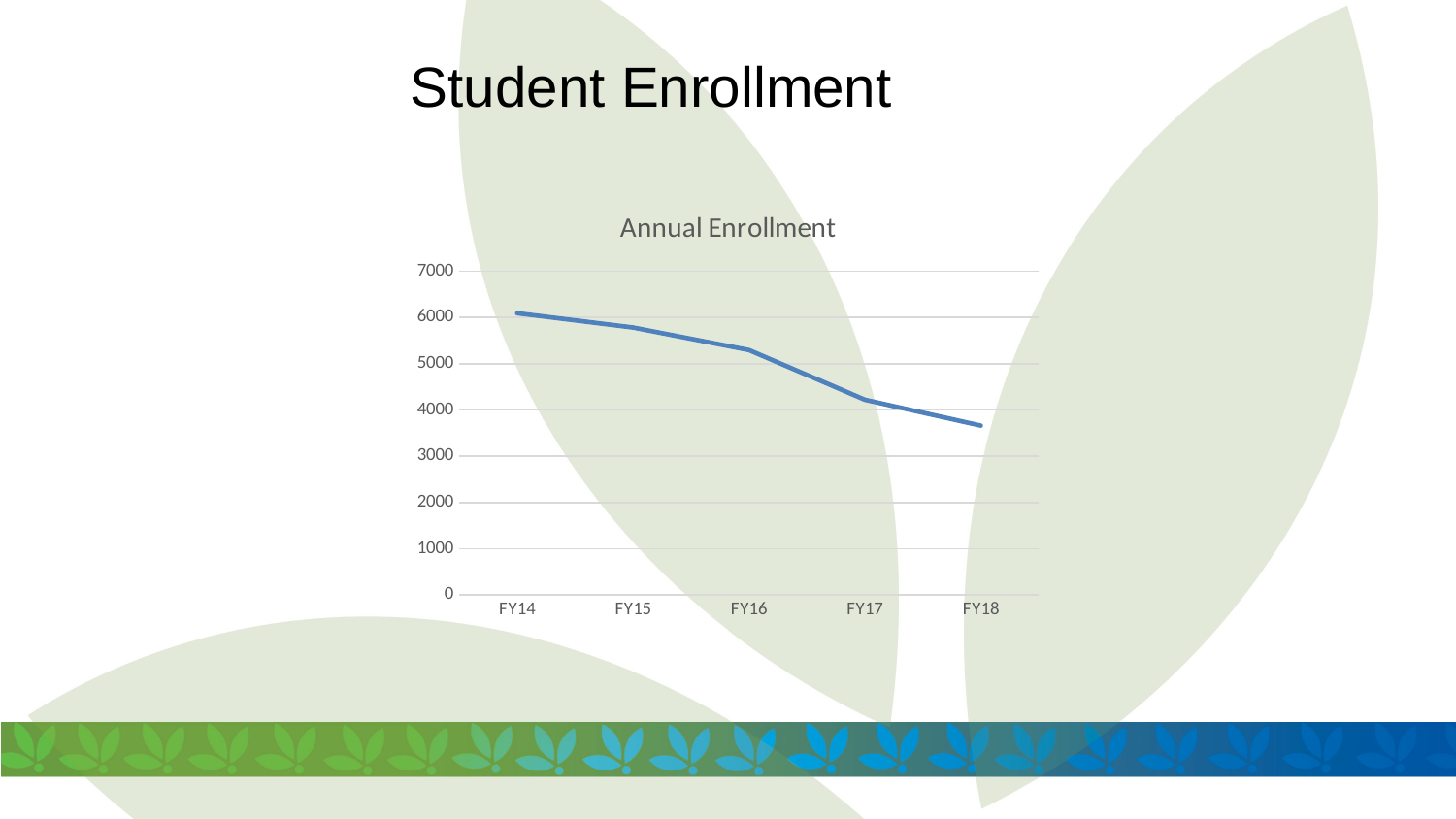
Which has the larger enrollment, FY16 or FY17? FY16 Is the enrollment for FY17 greater or less than 5000? less What is the highest value shown on the y axis? 7000 What is the title of the chart? Annual Enrollment Which fiscal year has the lowest enrollment? FY18 Do the enrollment values rise or fall from FY14 to FY18? fall Which fiscal year has the highest enrollment? FY14 Is the enrollment for FY18 greater or less than 4000? less What kind of chart is shown on the slide? line chart How many fiscal years are plotted on the x axis? 5 Is the enrollment for FY16 greater or less than 5000? greater